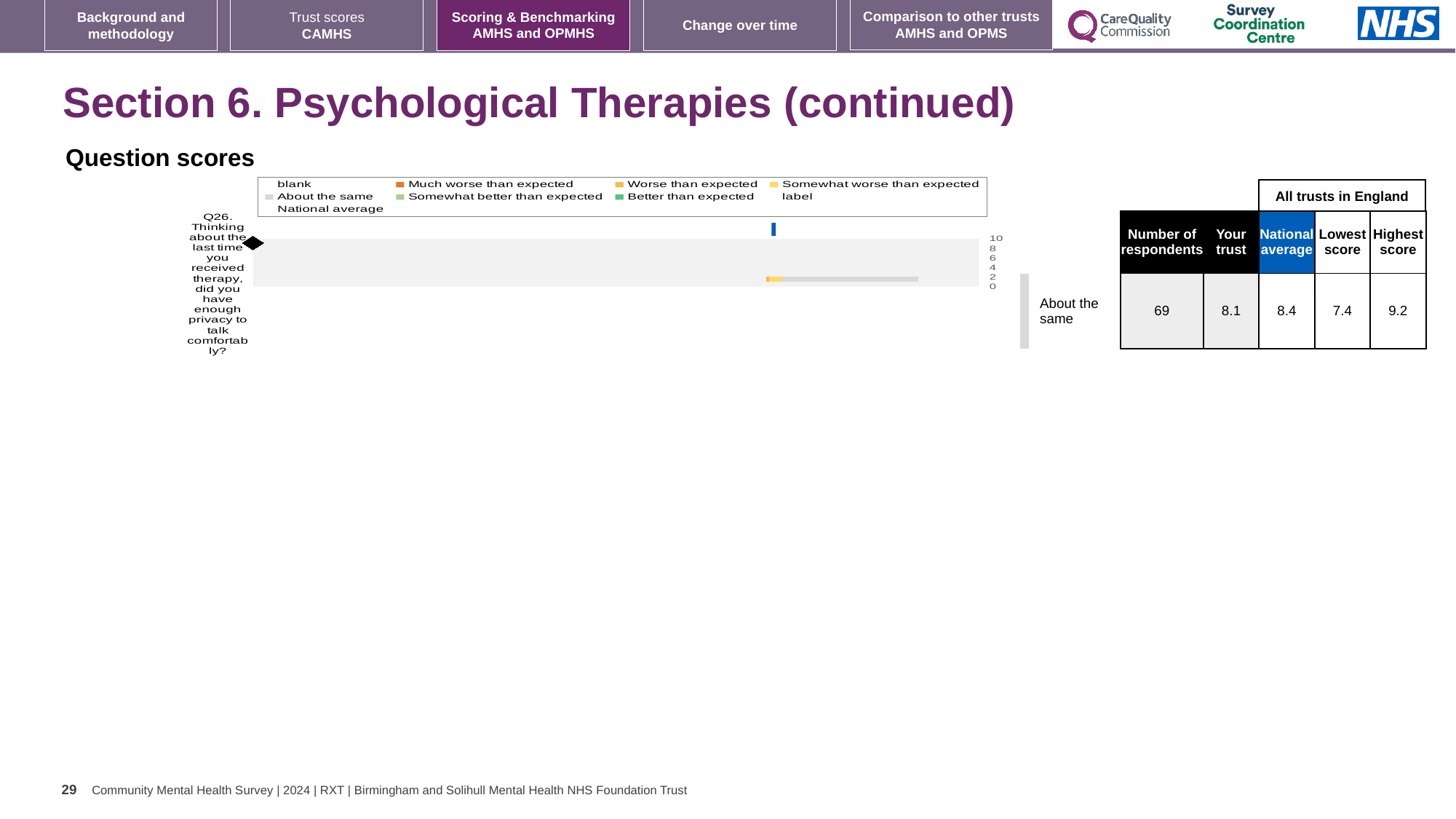
According to the table next to the chart, what is the 'Your trust' score for Q26? 8.1 What is the difference between the highest score and the lowest score for Q26 in the table next to the chart? 1.8 How many respondents answered Q26, according to the table next to the chart? 69 How many questions (categories) are plotted in the chart? 1 According to the table next to the chart, what is the national average score for Q26? 8.4 Which question is plotted in the chart? Q26. Thinking about the last time you received therapy, did you have enough privacy to talk comfortably? What kind of chart is shown under 'Question scores'? bar chart Which is larger for Q26: the 'Your trust' score or the national average? national average According to the table next to the chart, what is the highest score among all trusts in England for Q26? 9.2 According to the table next to the chart, what is the lowest score among all trusts in England for Q26? 7.4 What is the highest value shown on the chart's score axis? 10 What benchmark category is the trust's Q26 score placed in, as labelled beside the chart? About the same